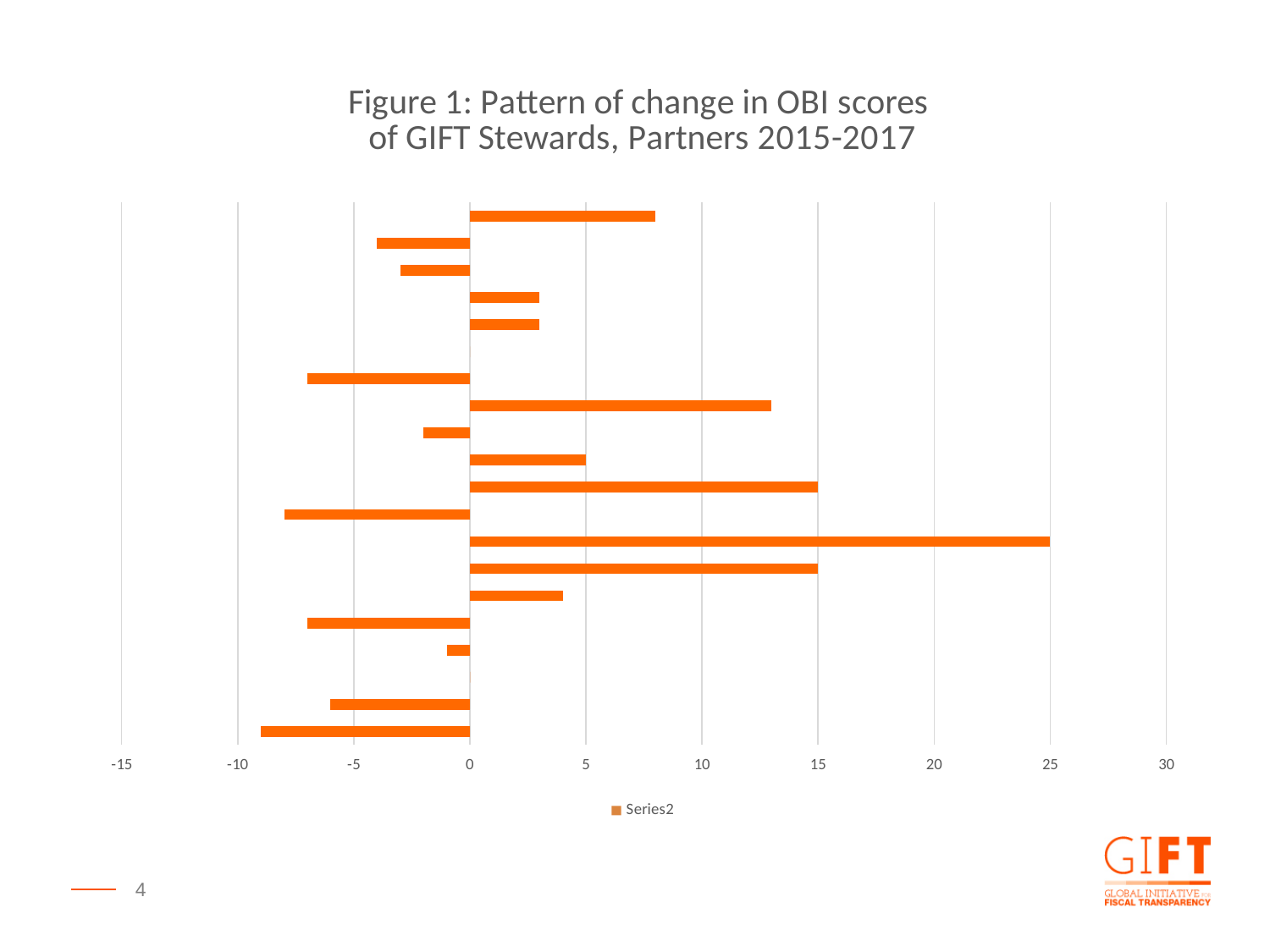
How many series does the legend list? 1 Is the value of the bottom bar greater or less than -5? less How many bars extend to the left of zero (negative values)? 9 What is the title of the chart? Figure 1: Pattern of change in OBI scores of GIFT Stewards, Partners 2015-2017 Is the value of the second bar from the top greater or less than 0? less What type of chart is shown on the slide? bar chart What is the name of the series shown in the legend? Series2 What is the value of the longest bar in the chart? 25 Which is larger: the value of the topmost bar or the value of the longest bar? the longest bar Is the value of the topmost bar greater or less than 5? greater